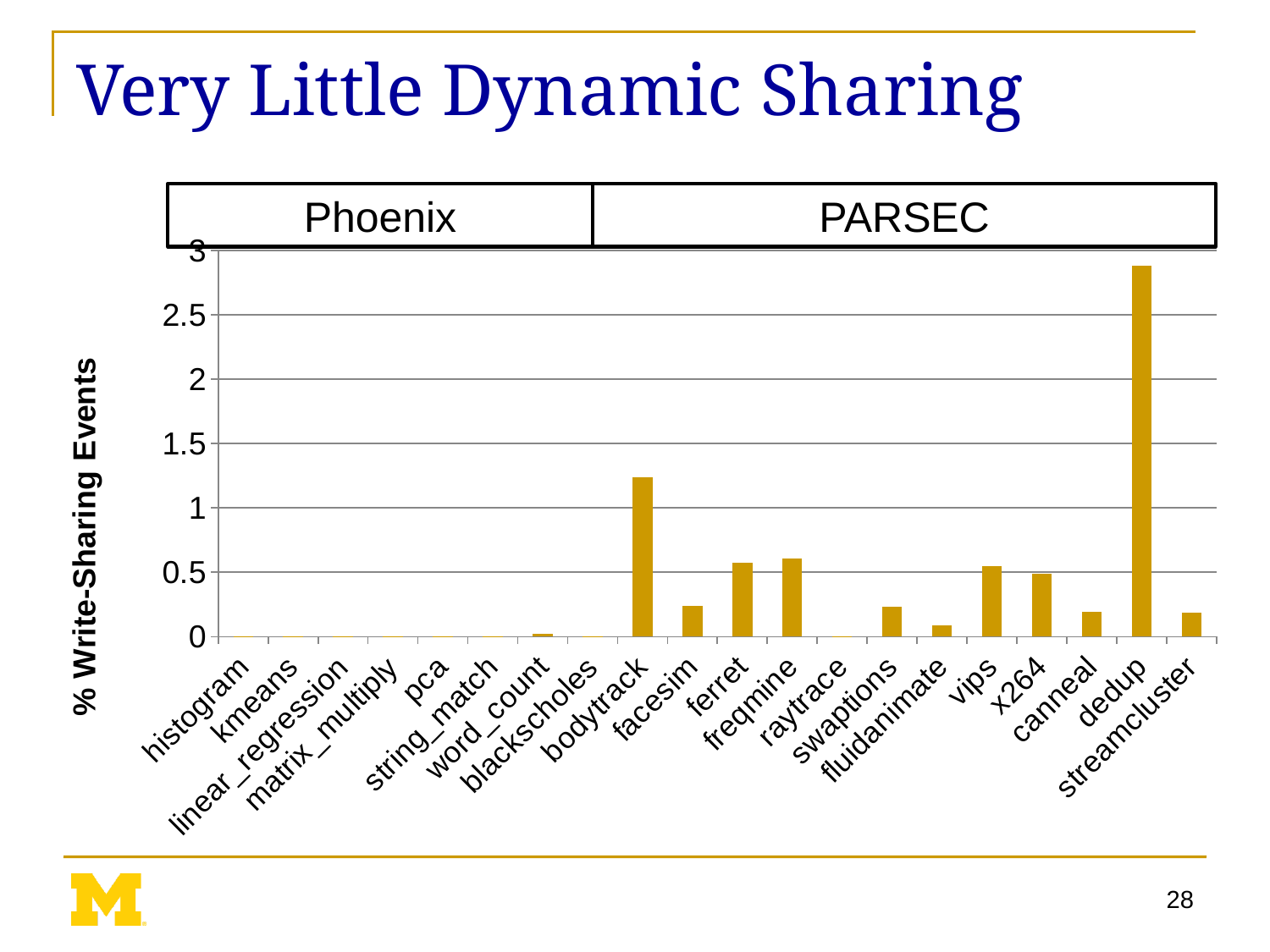
Is the value for fluidanimate greater or less than 0.5? less Is the value for bodytrack greater or less than 1.5? less Which has a higher % Write-Sharing Events, ferret or fluidanimate? ferret What is the label of the y axis of the chart? % Write-Sharing Events Which has a higher % Write-Sharing Events, dedup or bodytrack? dedup Which has a higher % Write-Sharing Events, bodytrack or ferret? bodytrack Which benchmark has the highest % Write-Sharing Events? dedup How many benchmarks are shown on the x axis of the chart? 20 Is the value for dedup greater or less than 2.5? greater What kind of chart is shown on the slide? bar chart